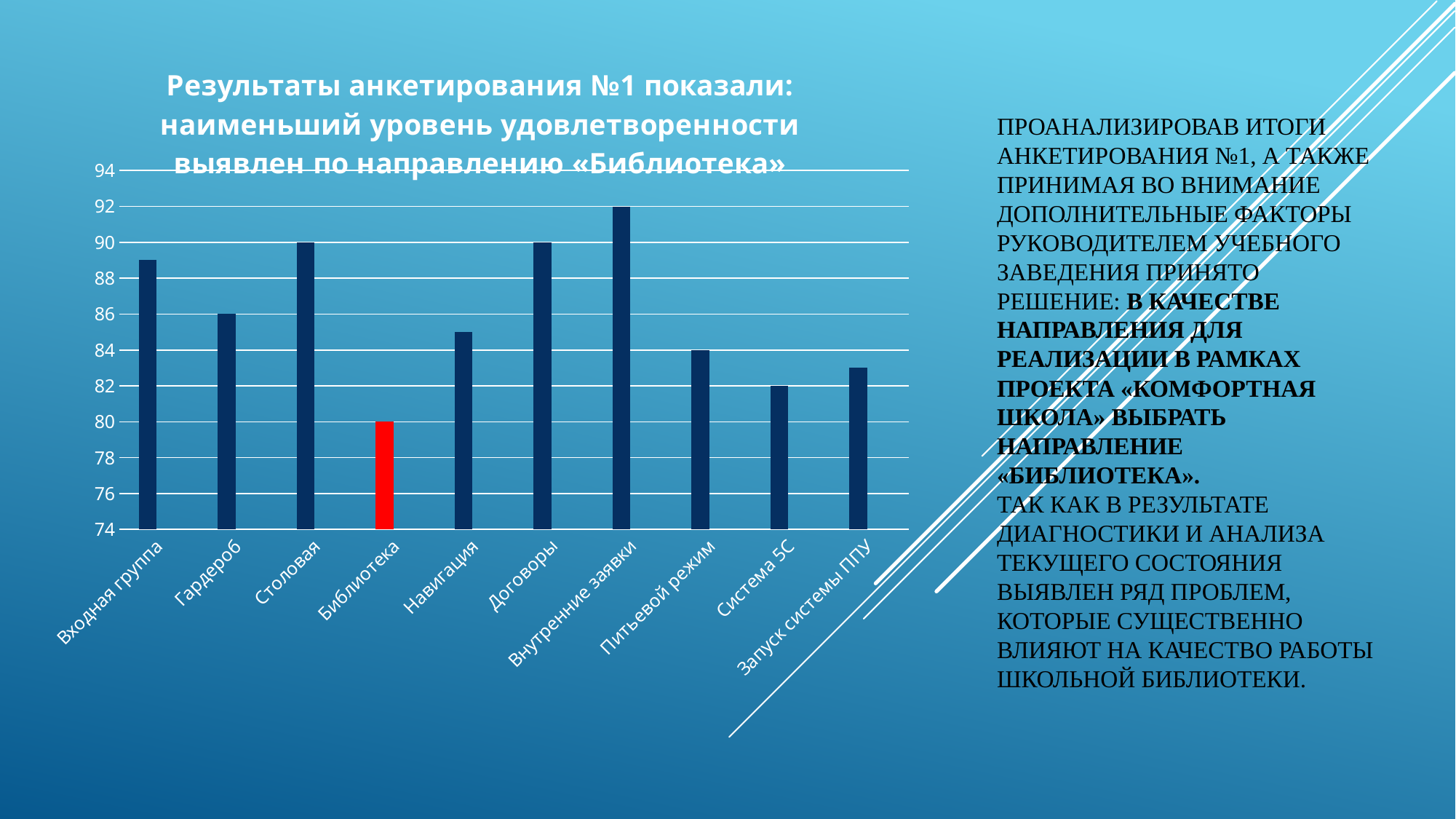
What is the value for Внутренние заявки? 92 What is the value for Гардероб? 86 What kind of chart is shown on the slide? bar chart Is the value for Входная группа greater or less than 90? less Which is larger, the value for Столовая or the value for Питьевой режим? Столовая Which category's bar is coloured red on the chart? Библиотека How many categories are plotted on the chart? 10 Is the value for Навигация greater or less than 84? greater What is the difference between the values for Внутренние заявки and Библиотека? 12 What is the value for Библиотека? 80 Which category has the lowest value on the chart? Библиотека Which category has the highest value on the chart? Внутренние заявки